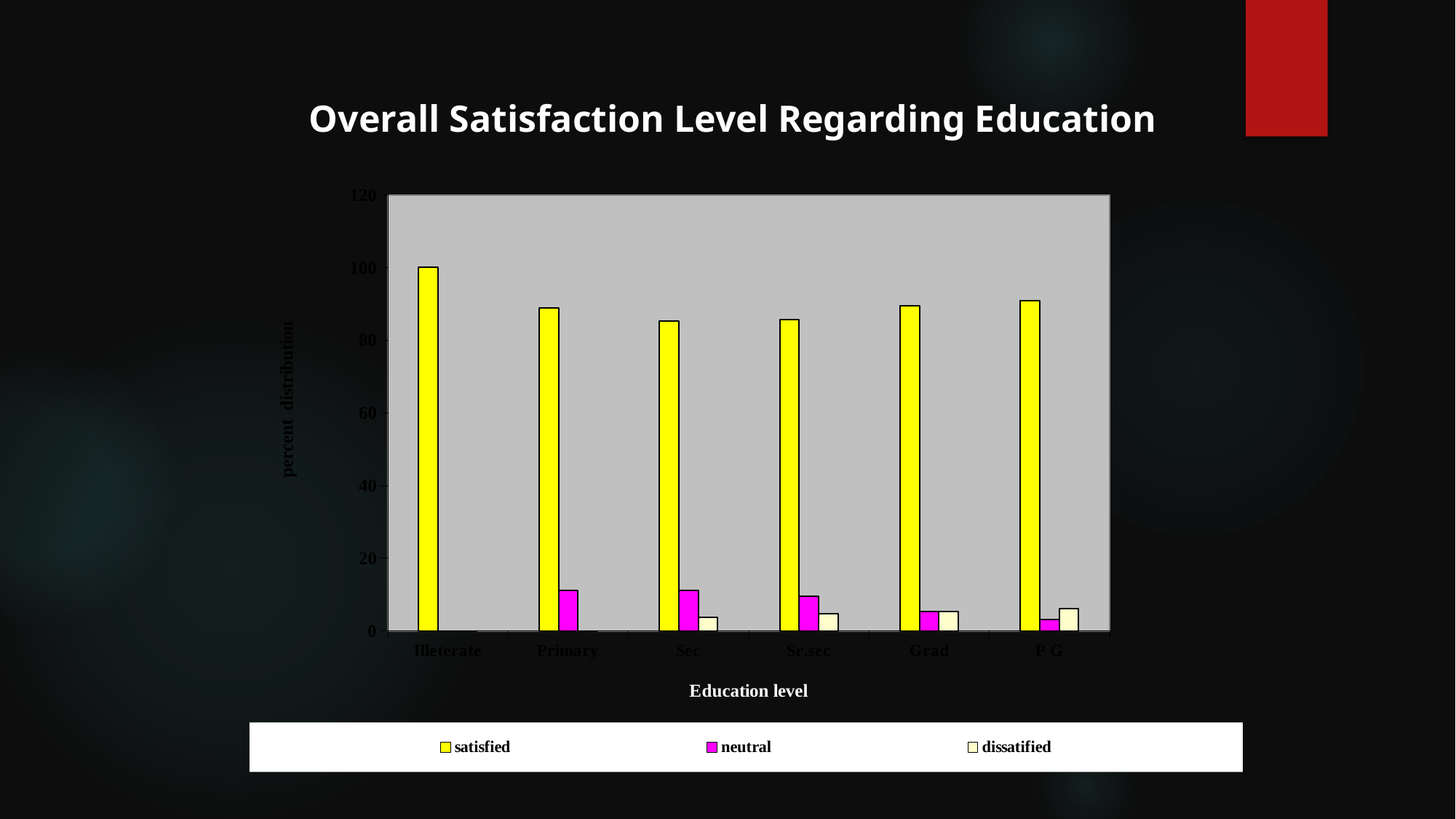
What is the title of the chart? Overall Satisfaction Level Regarding Education Is the satisfied value for Primary greater or less than 80? greater How many education level categories are shown on the x axis? 6 Is the dissatified value for P G greater or less than 20? less Which education level has the highest satisfied value? Illeterate What kind of chart is shown on the slide? bar chart What is the satisfied value for Illeterate? 100 What is the label of the x axis? Education level Which is larger, the satisfied value for Illeterate or the satisfied value for P G? Illeterate Is the neutral value for Primary greater or less than 20? less Which is larger, the neutral value for Primary or the neutral value for P G? Primary How many series does the legend list? 3